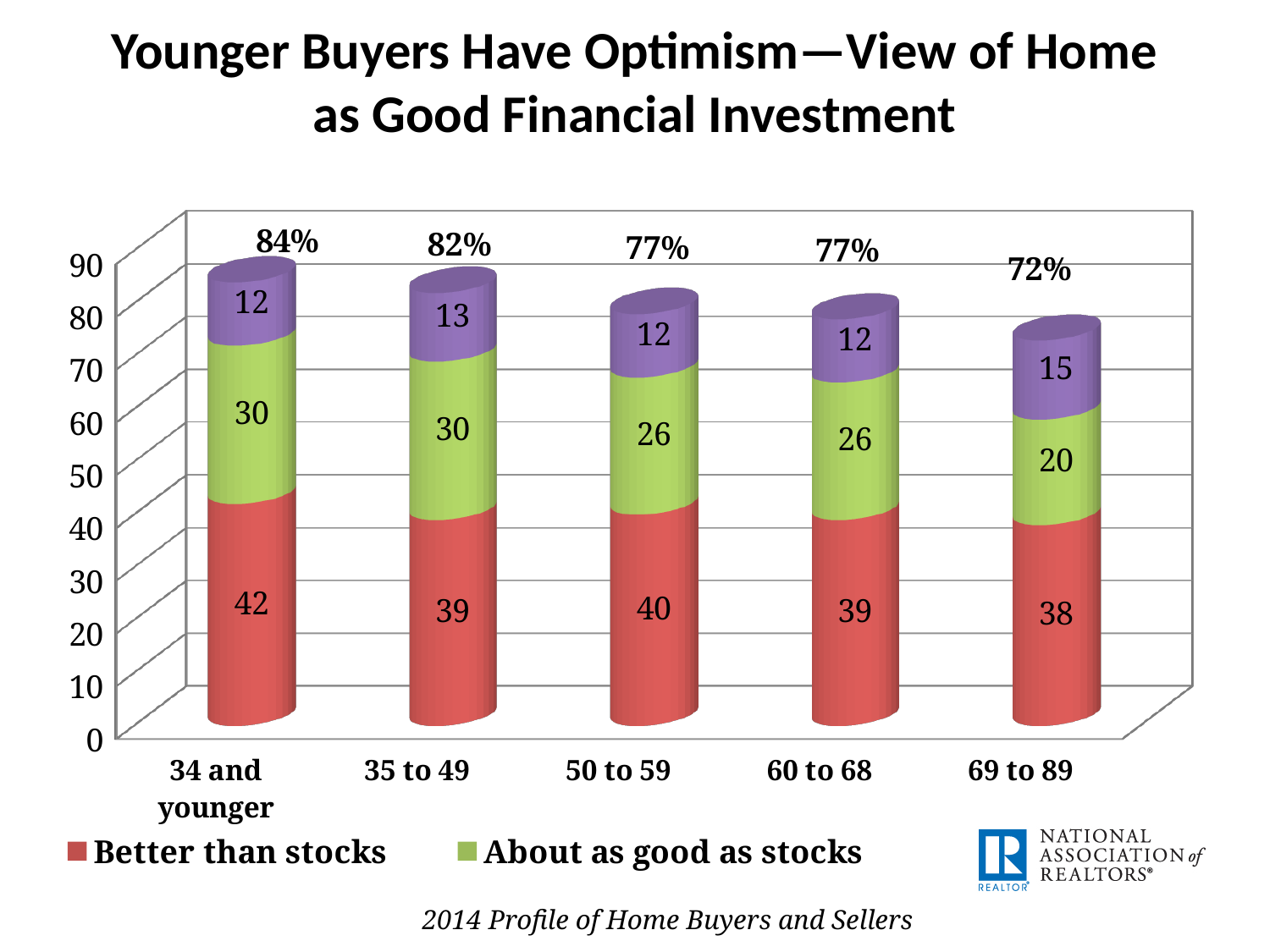
How many age groups are shown on the x axis? 5 What is the 'About as good as stocks' value for the '69 to 89' group? 20 Do the total percentages printed above the bars rise or fall from the youngest to the oldest age group? fall Which age group has the highest total percentage printed above its bar? 34 and younger What kind of chart is shown on the slide? stacked bar chart What colour represents 'Better than stocks' in the legend? red What is the 'Better than stocks' value for the '34 and younger' group? 42 Which is larger: the 'About as good as stocks' value for '35 to 49' or for '60 to 68'? 35 to 49 What is the difference between the 'Better than stocks' values for '34 and younger' and '69 to 89'? 4 What is the 'Better than stocks' value for the '50 to 59' group? 40 Which age group has the lowest total percentage printed above its bar? 69 to 89 What total percentage is printed above the bar for '35 to 49'? 82%